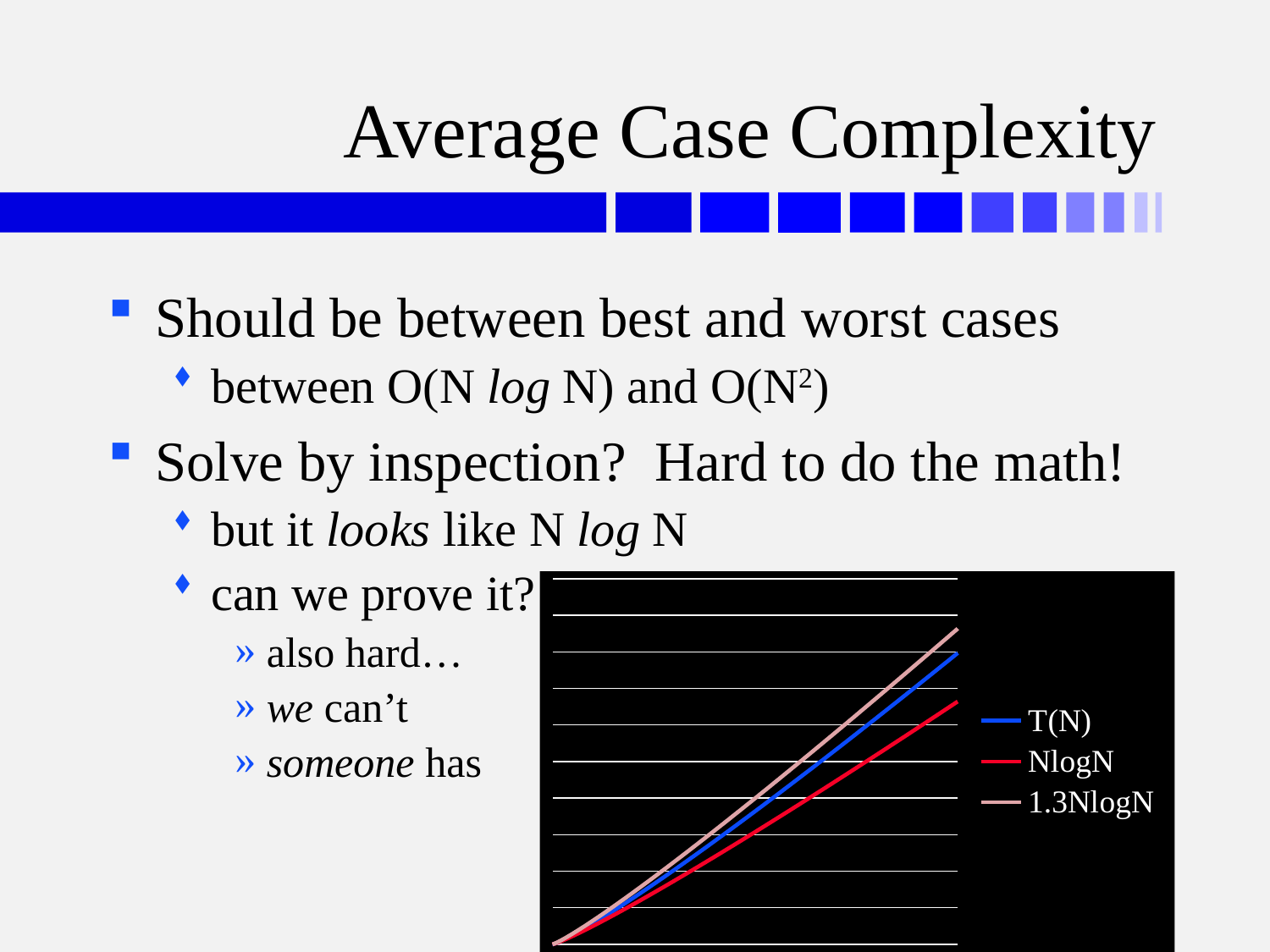
Which series reaches the highest value at the right end of the chart? 1.3NlogN Do the values of the T(N) line rise or fall from left to right? rise Which series lies between the other two at the right end of the chart? T(N) At the right end of the chart, which is larger: T(N) or NlogN? T(N) What are the three series named in the chart's legend? T(N), NlogN, 1.3NlogN How many series does the chart's legend list? 3 Which series has the lowest value at the right end of the chart? NlogN What colour is the line for the T(N) series? blue At the right end of the chart, which is larger: 1.3NlogN or T(N)? 1.3NlogN Do the values of the NlogN line rise or fall along the x axis? rise What kind of chart is shown on the slide? line chart